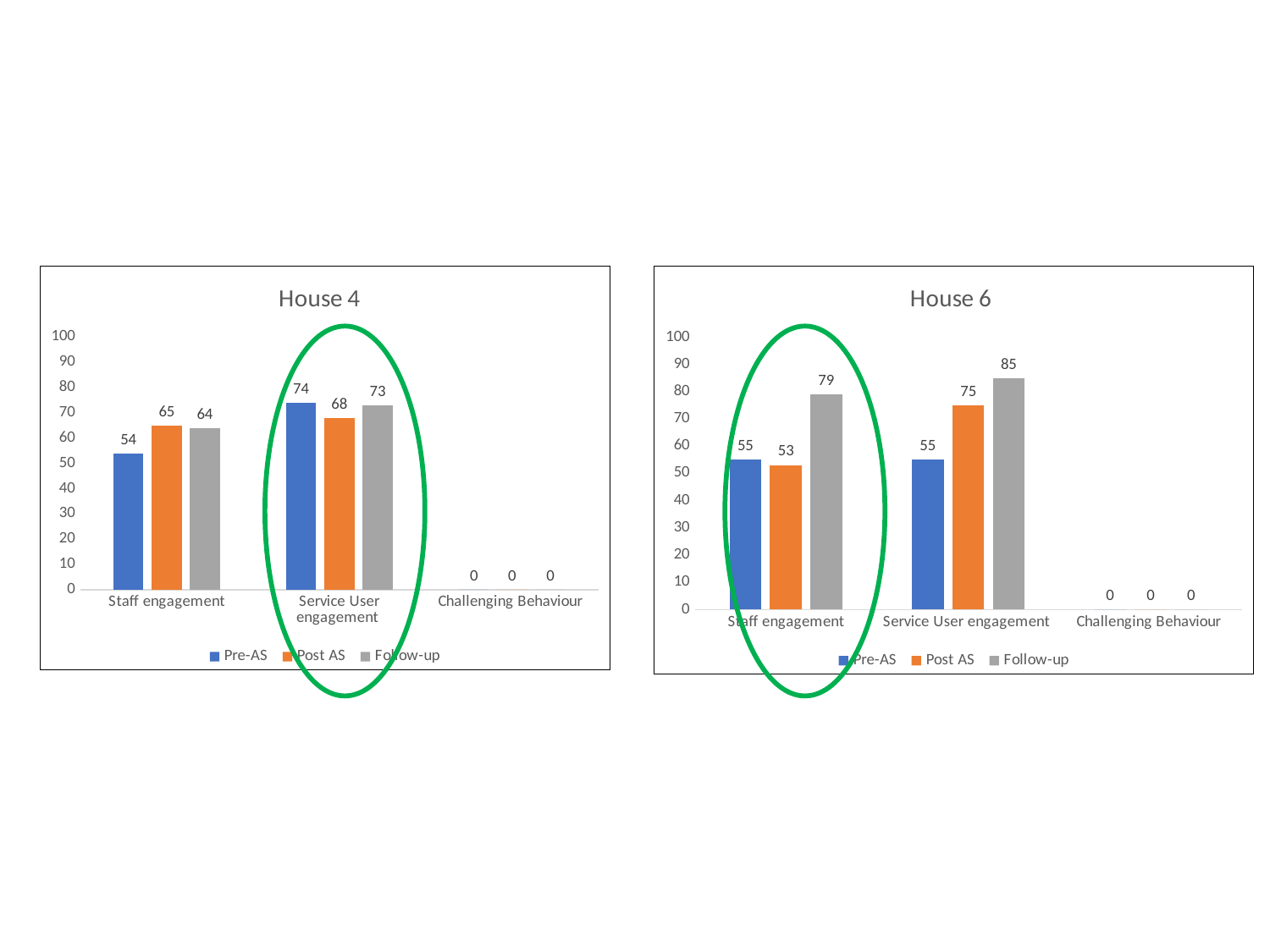
How many series does the legend of the House 4 chart list? 3 What kind of chart is the House 6 chart? Bar chart In the House 6 chart, what is the Follow-up value for Staff engagement? 79 In the House 4 chart, what is the difference between the Pre-AS and Post AS values for Staff engagement? 11 In the House 4 chart, which is larger for Service User engagement: the Pre-AS value or the Follow-up value? Pre-AS In the House 4 chart, what is the Pre-AS value for Staff engagement? 54 In the House 4 chart, what is the Post AS value for Service User engagement? 68 In the House 4 chart, which category has the lowest values across all series? Challenging Behaviour How many categories are shown on the x axis of the House 6 chart? 3 In the House 6 chart, which series has the highest value for Staff engagement? Follow-up In the House 6 chart, what is the Follow-up value for Service User engagement? 85 In the House 6 chart, what is the difference between the Follow-up and Pre-AS values for Staff engagement? 24